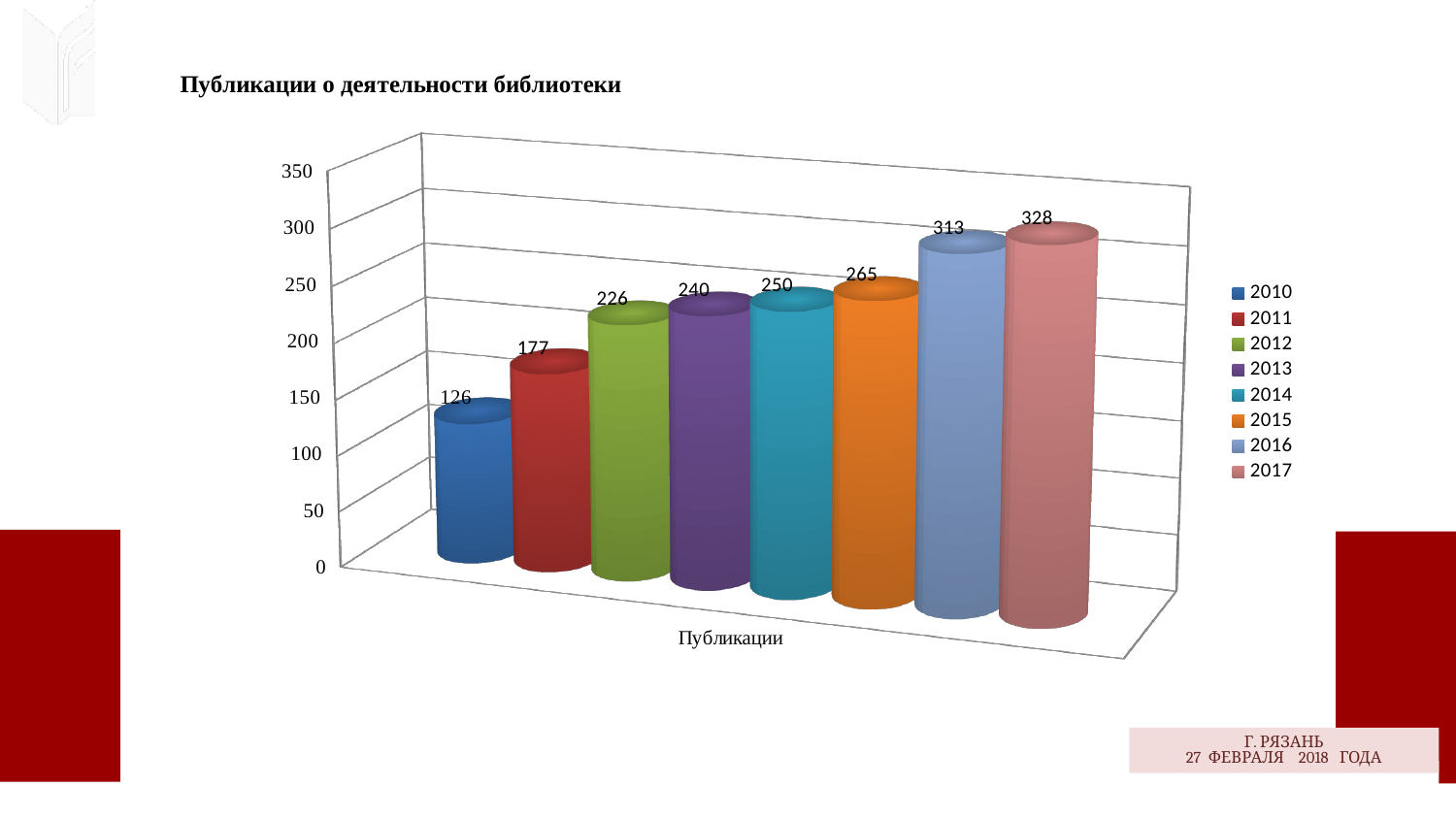
Which year has the lowest value? 2010 What is the value for 2010? 126 What kind of chart is shown? bar chart What is the value for 2017? 328 Is the value for 2011 greater or less than 200? less What is the difference between the values for 2017 and 2010? 202 What is the value for 2014? 250 What is the difference between the values for 2016 and 2015? 48 How many series does the legend list? 8 Which is larger, the value for 2012 or the value for 2013? 2013 Do the values rise or fall from 2010 to 2017? rise Which year has the highest value? 2017